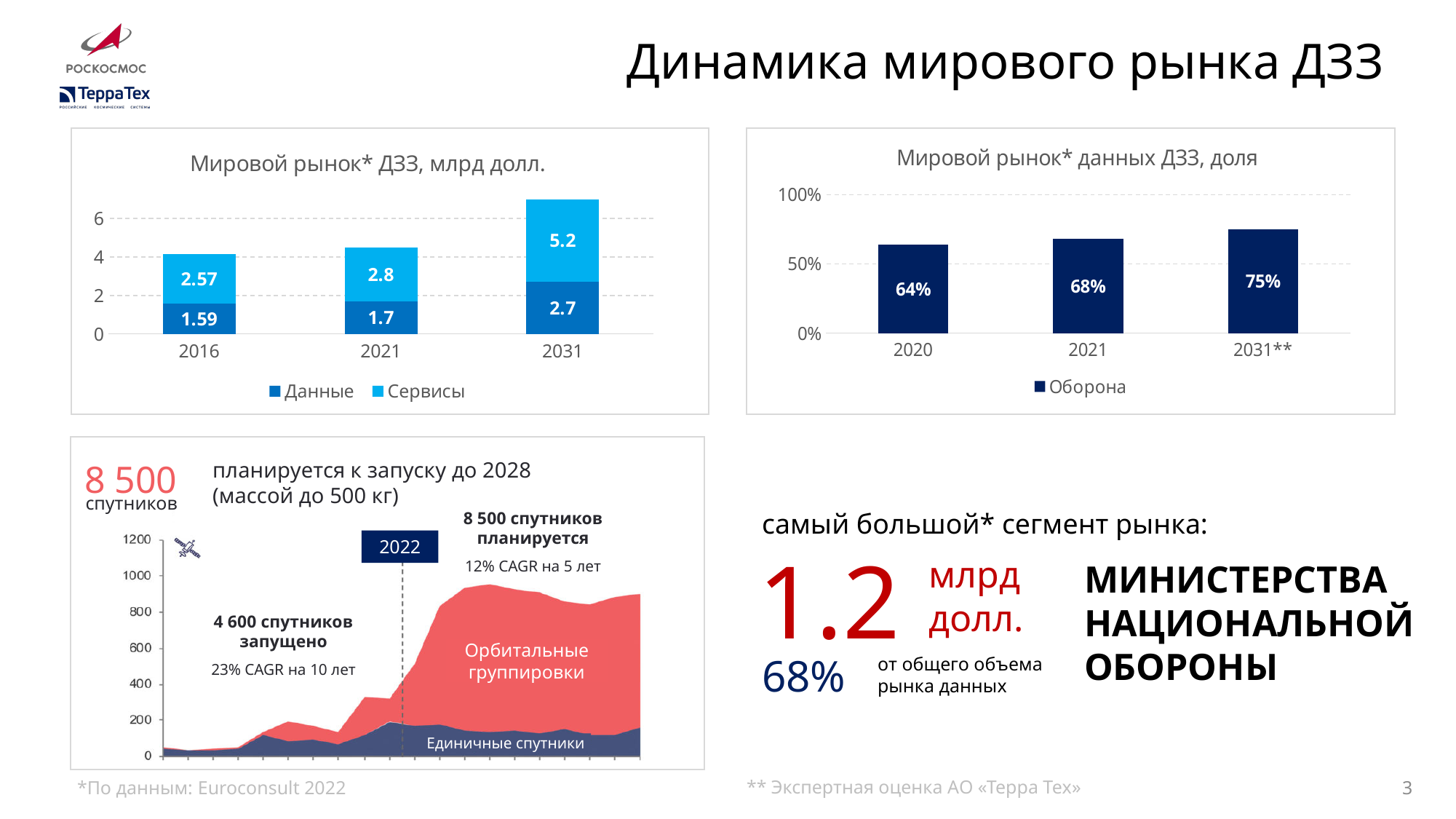
In the chart 'Мировой рынок* данных ДЗЗ, доля', which year has the lowest value? 2020 In the chart 'Мировой рынок* ДЗЗ, млрд долл.', how many series does the legend list? 2 In the chart 'Мировой рынок* данных ДЗЗ, доля', what is the value for 2021? 68% In the chart 'Мировой рынок* ДЗЗ, млрд долл.', which year has the highest total? 2031 In the chart 'Мировой рынок* ДЗЗ, млрд долл.', what is the value for Данные in 2016? 1.59 In the chart 'Мировой рынок* данных ДЗЗ, доля', do the values rise or fall from 2020 to 2031**? rise In the chart 'Мировой рынок* ДЗЗ, млрд долл.', what is the value for Сервисы in 2031? 5.2 In the chart 'Мировой рынок* ДЗЗ, млрд долл.', what is the difference between Сервисы and Данные in 2031? 2.5 What kind of chart is the one at the bottom left of the slide showing satellites? area chart In the chart 'Мировой рынок* ДЗЗ, млрд долл.', is the value for Сервисы in 2021 larger than the value for Данные in 2021? Yes In the chart 'Мировой рынок* данных ДЗЗ, доля', what is the difference between 2031** and 2020? 11% In the chart 'Мировой рынок* ДЗЗ, млрд долл.', what is the total of the stacked bar for 2021? 4.5